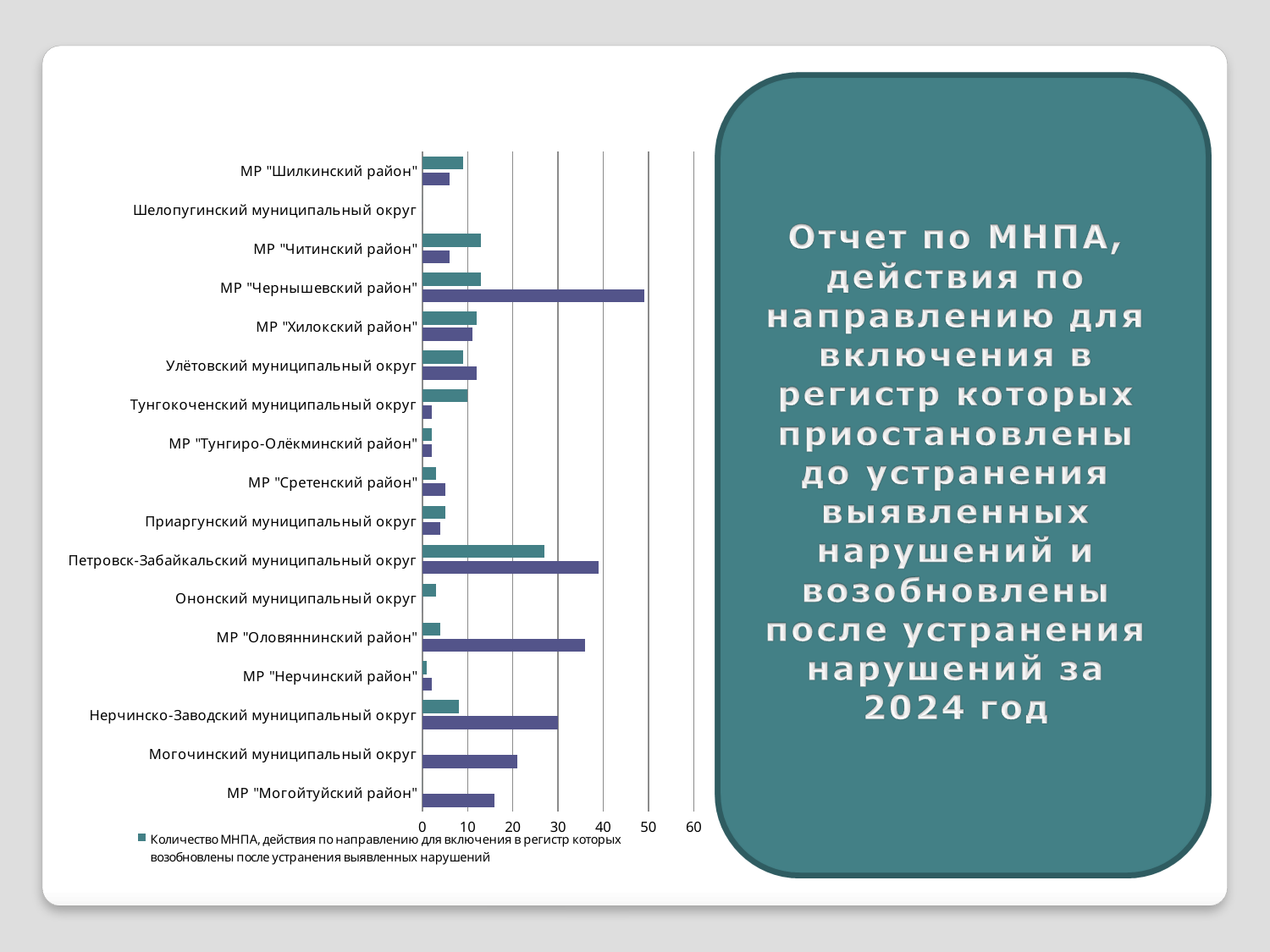
Which category has the longest purple bar in the chart? МР "Чернышевский район" Is the purple bar for МР "Чернышевский район" greater or less than 40? greater Which has the longer teal bar: Петровск-Забайкальский муниципальный округ or МР "Читинский район"? Петровск-Забайкальский муниципальный округ What kind of chart is shown on the slide? bar chart Which category on the chart shows no bars at all? Шелопугинский муниципальный округ Is the purple bar for МР "Оловяннинский район" greater or less than 30? greater Is the purple bar for МР "Могойтуйский район" greater or less than 20? less How many categories (municipal districts) are listed on the vertical axis of the chart? 17 Which category has the longest teal bar in the chart? Петровск-Забайкальский муниципальный округ How many entries does the chart's legend list? 1 Which has the longer purple bar: МР "Чернышевский район" or МР "Оловяннинский район"? МР "Чернышевский район"